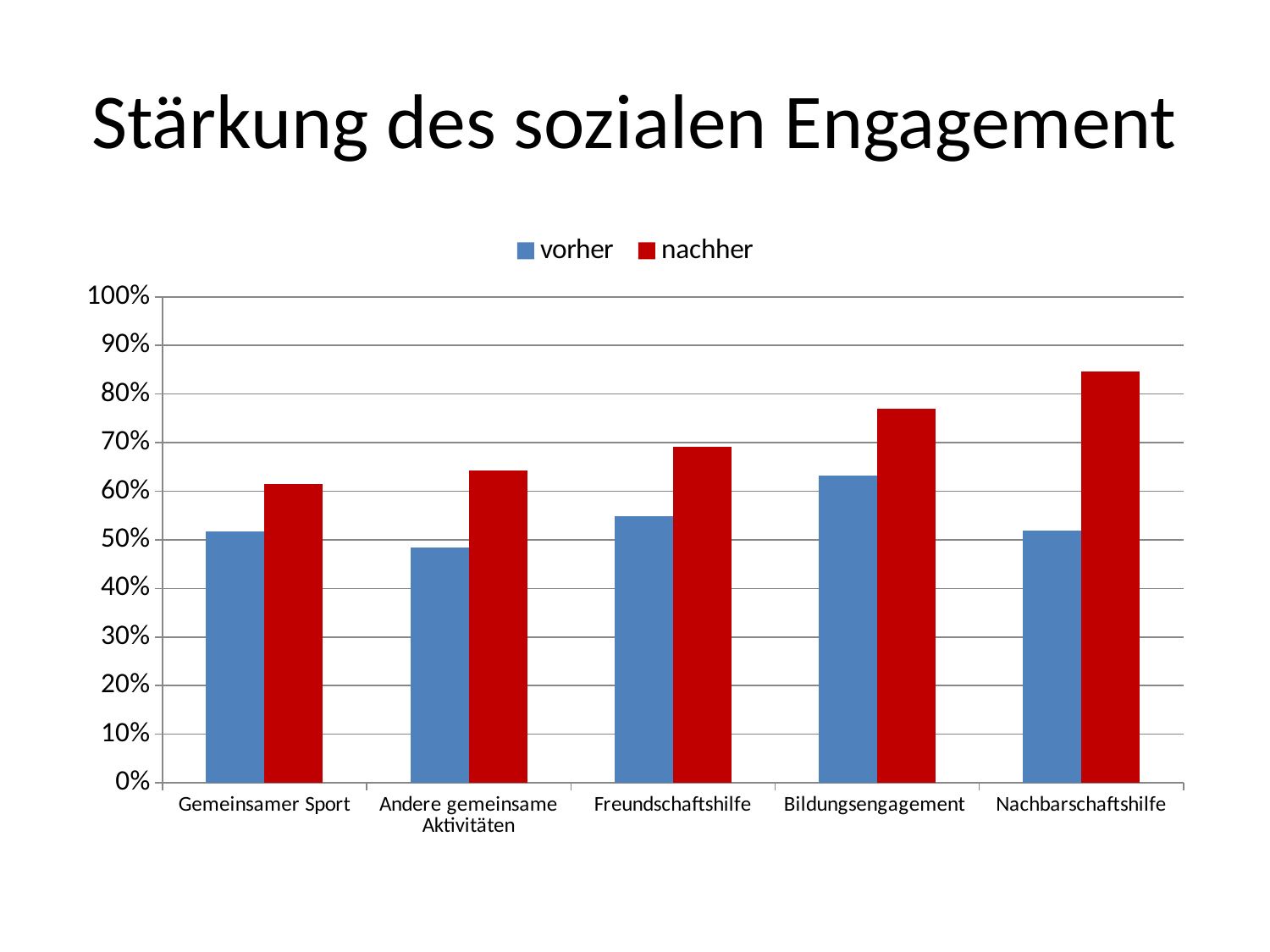
Which category has the lowest 'vorher' value? Andere gemeinsame Aktivitäten How many series does the legend list? 2 For Freundschaftshilfe, which is larger: the 'vorher' value or the 'nachher' value? nachher How many categories are shown on the x axis? 5 Is the 'vorher' value for Bildungsengagement greater or less than 60%? greater Which category has the highest 'nachher' value? Nachbarschaftshilfe What is the title of the slide? Stärkung des sozialen Engagement Is the 'nachher' value for Nachbarschaftshilfe greater or less than 80%? greater Which category has the highest 'vorher' value? Bildungsengagement What kind of chart is shown on the slide? bar chart Which is larger: the 'nachher' value for Bildungsengagement or the 'nachher' value for Gemeinsamer Sport? Bildungsengagement Is the 'vorher' value for Andere gemeinsame Aktivitäten greater or less than 50%? less